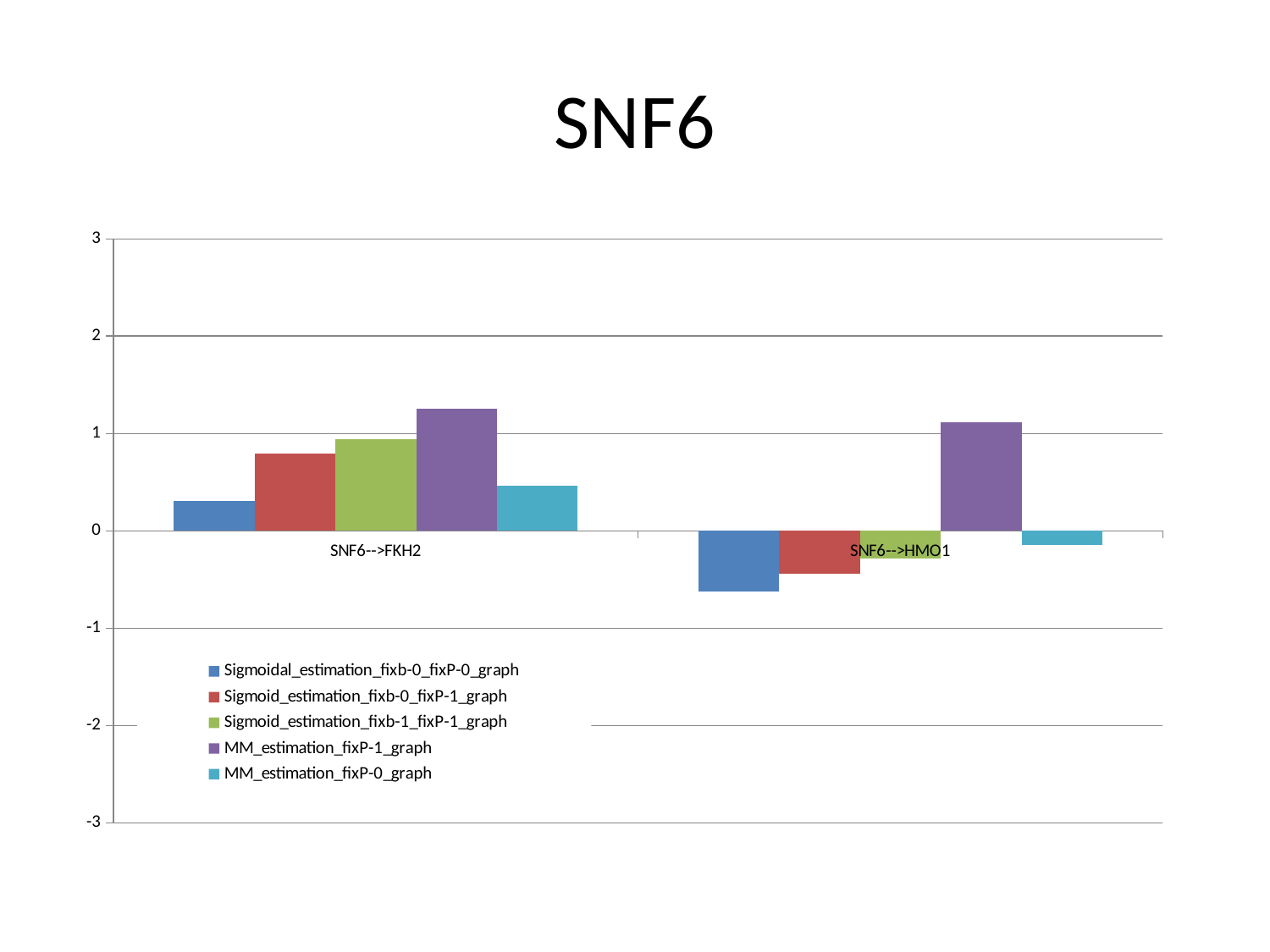
How many series does the legend list? 5 For SNF6-->FKH2, which is larger: Sigmoid_estimation_fixb-1_fixP-1_graph or MM_estimation_fixP-0_graph? Sigmoid_estimation_fixb-1_fixP-1_graph What kind of chart is shown on the slide? bar chart Which series has the highest value for SNF6-->HMO1? MM_estimation_fixP-1_graph Is the value of Sigmoidal_estimation_fixb-0_fixP-0_graph for SNF6-->HMO1 greater or less than 0? less Is the value of MM_estimation_fixP-1_graph for SNF6-->FKH2 greater or less than 1? greater Which series has the highest value for SNF6-->FKH2? MM_estimation_fixP-1_graph How many categories are shown on the x axis? 2 Which series has the lowest value for SNF6-->HMO1? Sigmoidal_estimation_fixb-0_fixP-0_graph Which series has the lowest value for SNF6-->FKH2? Sigmoidal_estimation_fixb-0_fixP-0_graph What is the title of the chart? SNF6 For SNF6-->FKH2, which is larger: Sigmoid_estimation_fixb-0_fixP-1_graph or Sigmoidal_estimation_fixb-0_fixP-0_graph? Sigmoid_estimation_fixb-0_fixP-1_graph